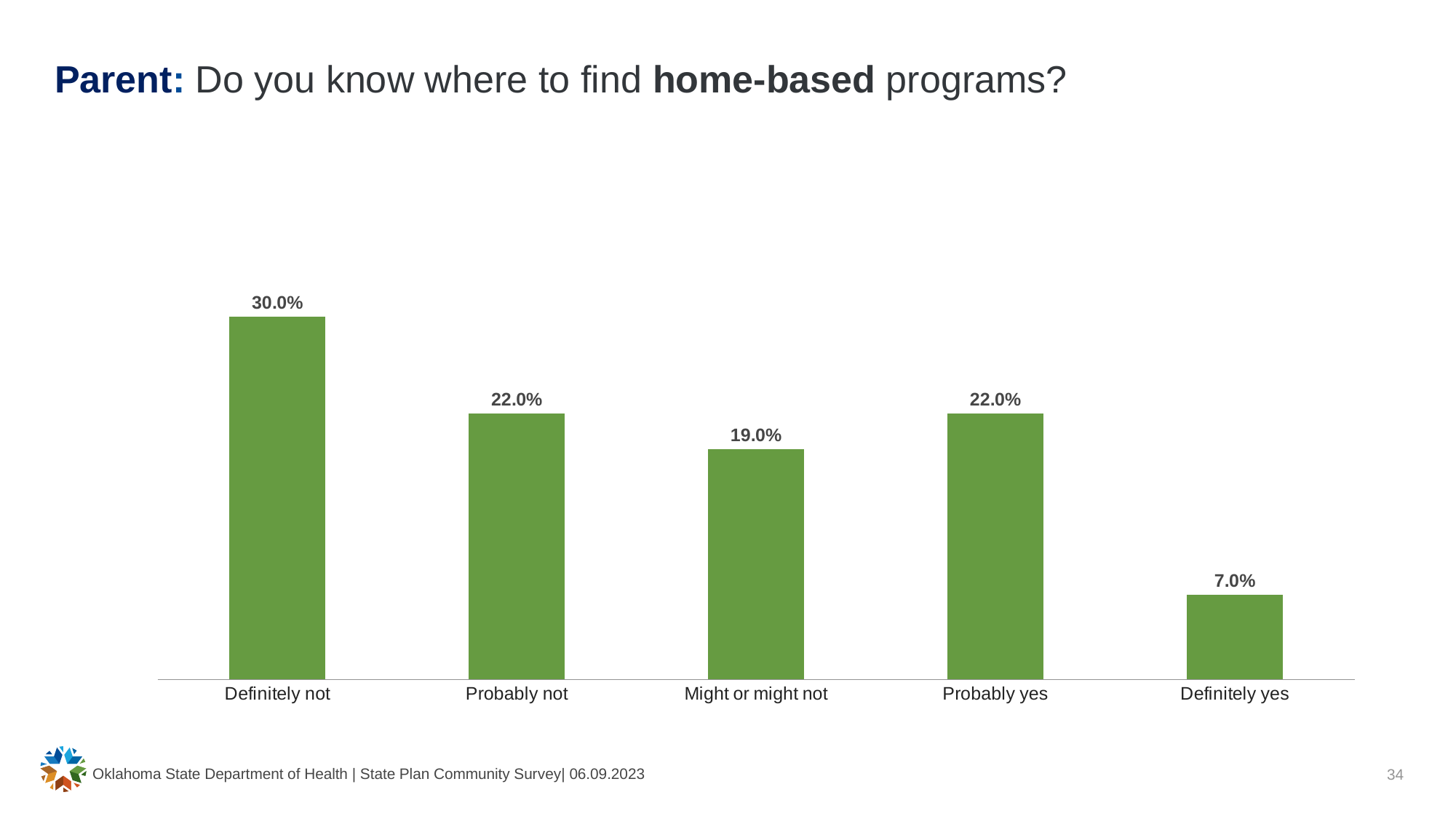
What percentage of parents answered "Definitely not"? 30.0% What is the value for "Definitely yes"? 7.0% What is the value for "Probably yes"? 22.0% How many response categories are shown on the chart? 5 Which is larger, the value for "Definitely not" or the value for "Probably yes"? Definitely not Which response category has the highest value? Definitely not What is the value for "Might or might not"? 19.0% Which two response categories have the same value? Probably not and Probably yes What is the difference between "Definitely not" and "Definitely yes"? 23.0% Which response category has the lowest value? Definitely yes What is the difference between "Probably not" and "Might or might not"? 3.0% What kind of chart is shown on the slide? Bar chart